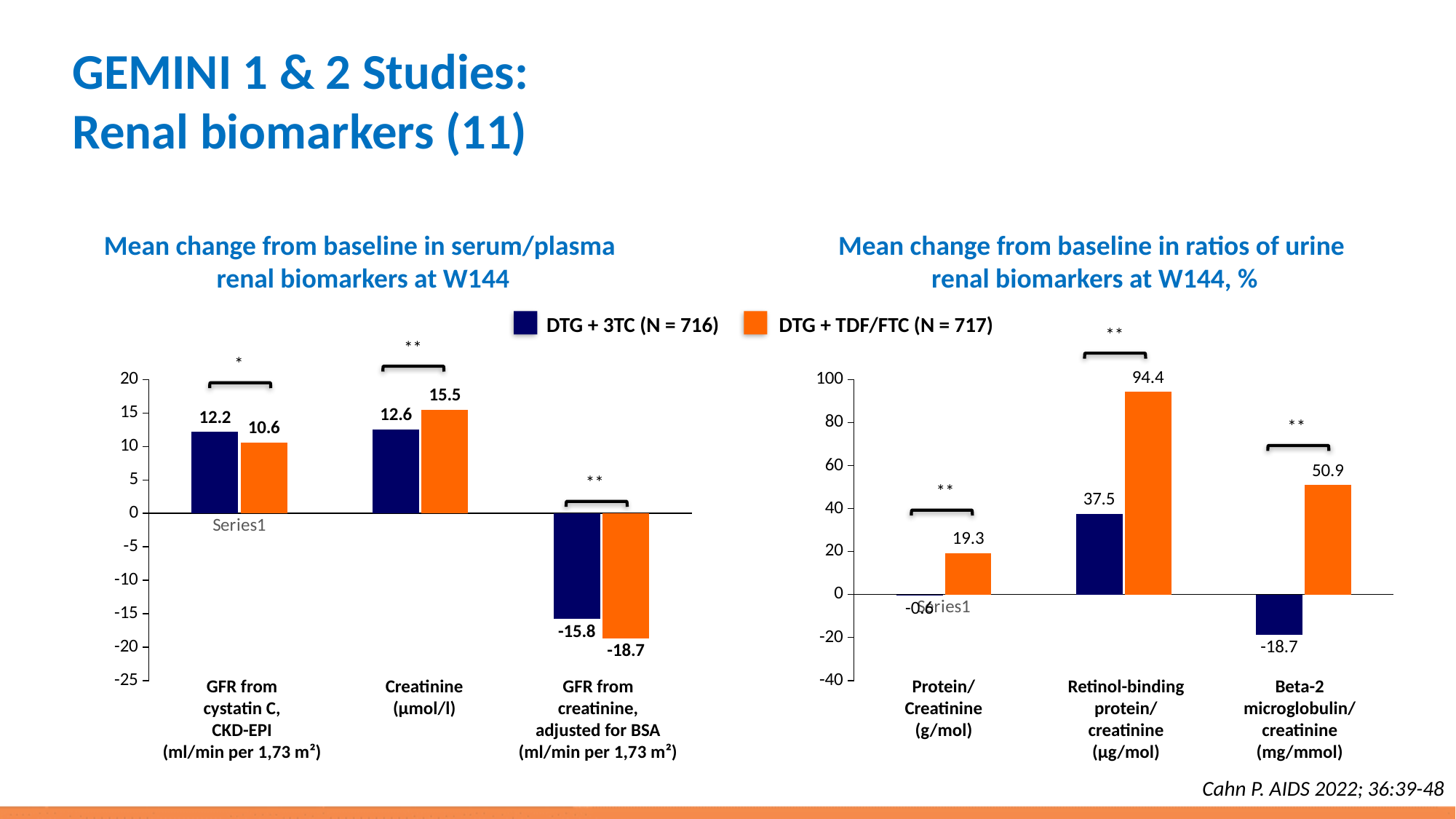
In the right chart (ratios of urine renal biomarkers), which category has the highest DTG + TDF/FTC value? Retinol-binding protein/creatinine In the right chart (ratios of urine renal biomarkers), what is the value for DTG + 3TC for Beta-2 microglobulin/creatinine? -18.7 In the left chart (serum/plasma renal biomarkers), what is the value for DTG + TDF/FTC for GFR from creatinine, adjusted for BSA? -18.7 In the right chart (ratios of urine renal biomarkers), what is the value for DTG + TDF/FTC for Retinol-binding protein/creatinine? 94.4 In the right chart (ratios of urine renal biomarkers), what is the difference between the DTG + TDF/FTC and DTG + 3TC values for Retinol-binding protein/creatinine? 56.9 How many series does the legend list? 2 In the right chart (ratios of urine renal biomarkers), is the DTG + TDF/FTC value for Beta-2 microglobulin/creatinine greater or less than 40? greater In the left chart (serum/plasma renal biomarkers), what is the value for DTG + 3TC for GFR from cystatin C, CKD-EPI? 12.2 In the left chart (serum/plasma renal biomarkers), what is the value for DTG + TDF/FTC for Creatinine (µmol/l)? 15.5 In the left chart (serum/plasma renal biomarkers), which series has the larger value for GFR from cystatin C, CKD-EPI? DTG + 3TC (N = 716) In the left chart (serum/plasma renal biomarkers), what is the difference between the DTG + TDF/FTC and DTG + 3TC values for Creatinine? 2.9 What type of chart is the left chart (serum/plasma renal biomarkers)? Bar chart